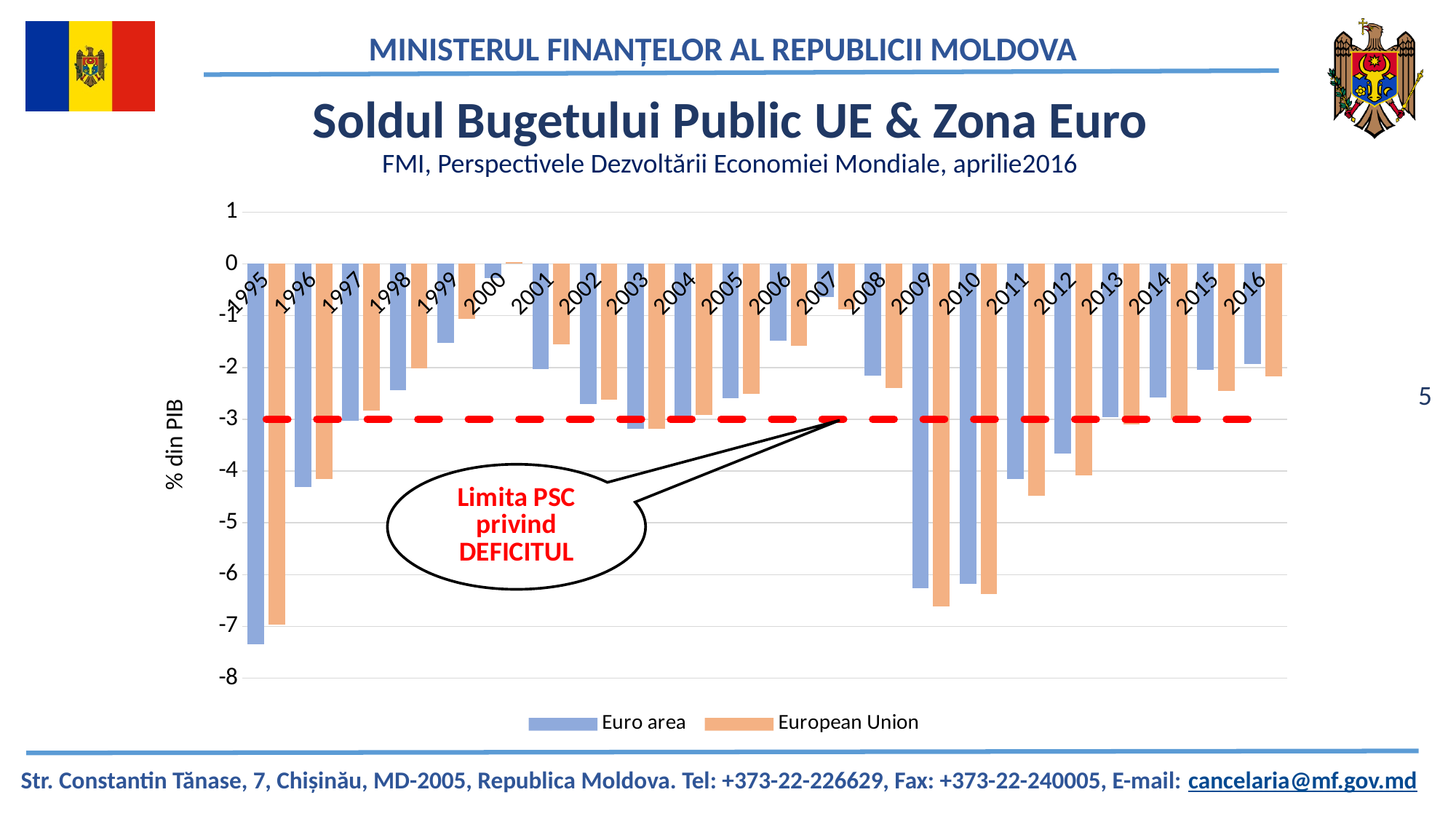
Which is lower, the Euro area value for 1995 or the Euro area value for 1996? 1995 Do the Euro area values rise or fall from 2009 to 2016? rise How many years are shown on the x axis of the chart? 22 Is the European Union value for 2009 greater or less than -6? less How many series does the legend list? 2 Is the Euro area value for 2007 greater or less than -1? greater Is the Euro area value for 1995 greater or less than -7? less What kind of chart is shown on the slide? bar chart At what value on the y axis is the red dashed line drawn? -3 Which year has the lowest European Union value? 1995 Which year has the lowest Euro area value? 1995